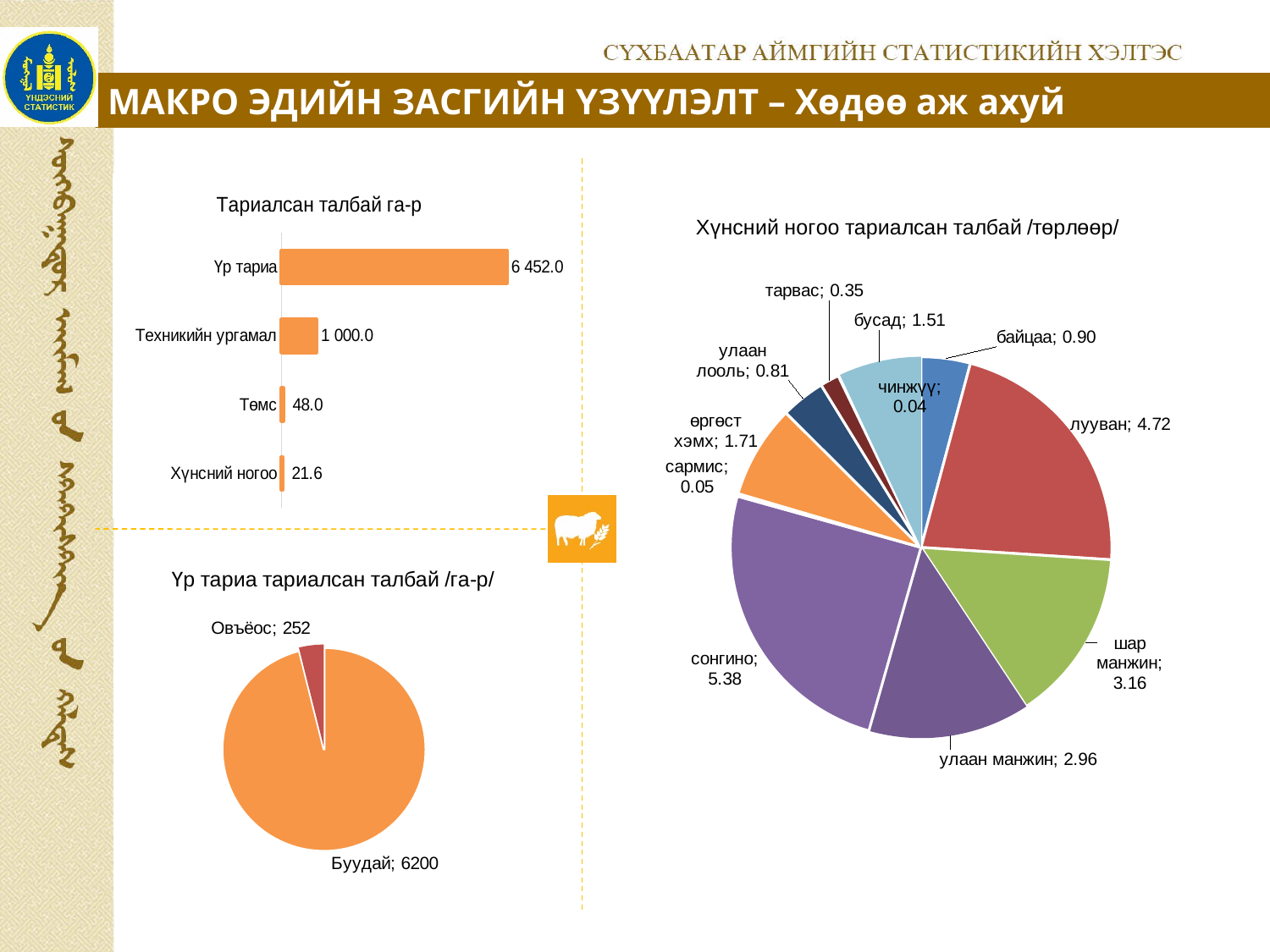
In the chart titled "Тариалсан талбай га-р", what is the value for Үр тариа? 6 452.0 In the chart titled "Хүнсний ногоо тариалсан талбай /төрлөөр/", what is the value for лууван? 4.72 In the chart titled "Үр тариа тариалсан талбай /га-р/", which slice is larger, Буудай or Овъёос? Буудай How many categories are shown in the chart titled "Тариалсан талбай га-р"? 4 In the chart titled "Хүнсний ногоо тариалсан талбай /төрлөөр/", which slice has the lowest value? чинжүү In the chart titled "Тариалсан талбай га-р", what is the value for Төмс? 48.0 In the chart titled "Хүнсний ногоо тариалсан талбай /төрлөөр/", which slice has the highest value? сонгино In the chart titled "Үр тариа тариалсан талбай /га-р/", what is the value for Овъёос? 252 In the chart titled "Тариалсан талбай га-р", what is the difference between Үр тариа and Техникийн ургамал? 5 452.0 How many slices are in the chart titled "Хүнсний ногоо тариалсан талбай /төрлөөр/"? 11 In the chart titled "Тариалсан талбай га-р", which category has the lowest value? Хүнсний ногоо What kind of chart is the chart titled "Тариалсан талбай га-р"? bar chart